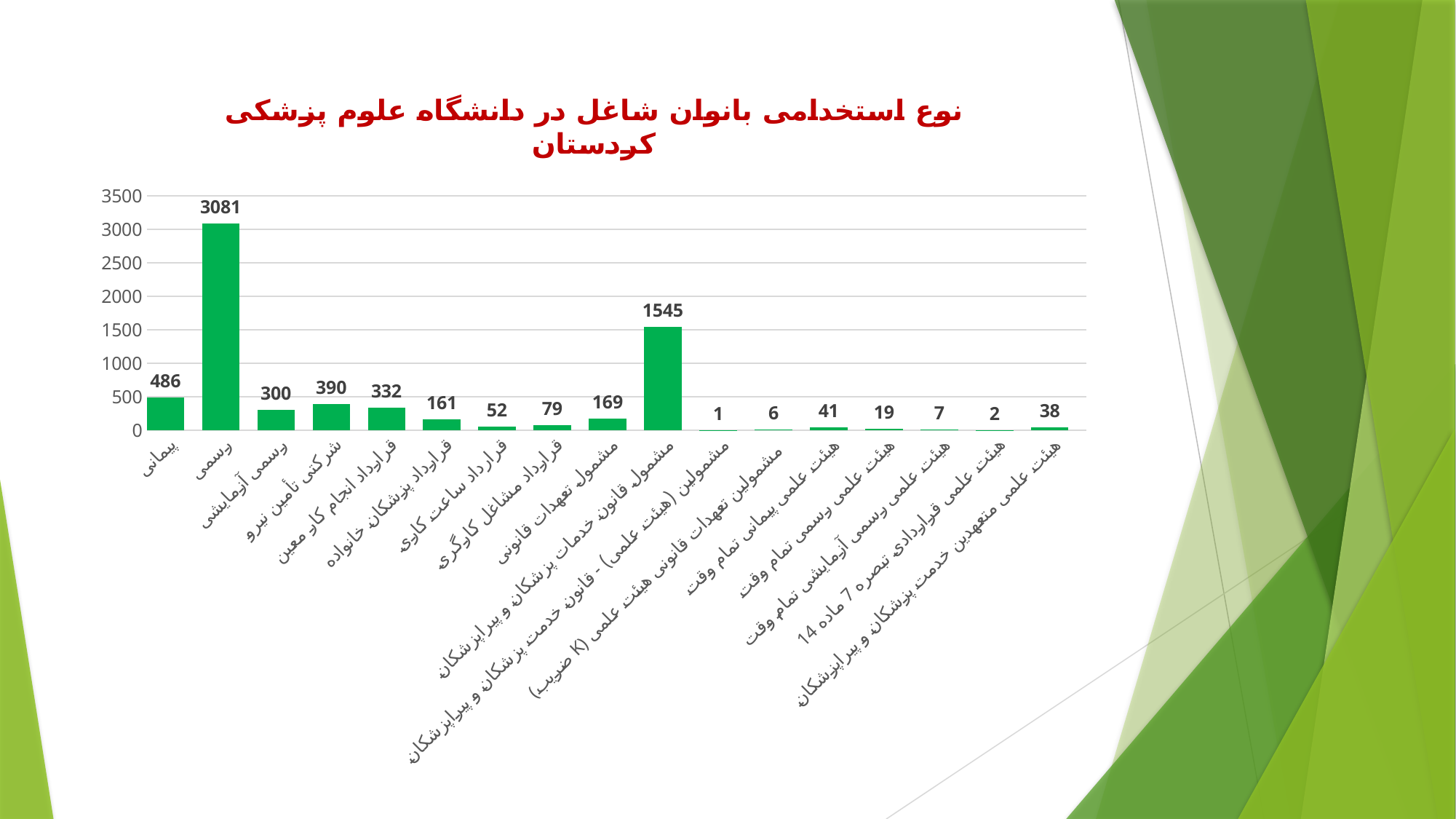
Which category has the lowest value? مشمولین (هیئت علمی) - قانون خدمت پزشکان و پیراپزشکان What is the value for پیمانی? 486 What type of chart is shown on the slide? bar chart Which is larger, the value for شرکتی تأمین نیرو or the value for قرارداد انجام کار معین? شرکتی تأمین نیرو What is the value for مشمول قانون خدمت پزشکان و پیراپزشکان? 1545 How many categories are shown on the x axis? 17 What colour are the bars in the chart? green What is the difference between the values for پیمانی and رسمی آزمایشی? 186 What is the difference between the values for رسمی and مشمول قانون خدمت پزشکان و پیراپزشکان? 1536 Which category has the highest value? رسمی What is the value for رسمی? 3081 What is the value for هیئت علمی پیمانی تمام وقت? 41